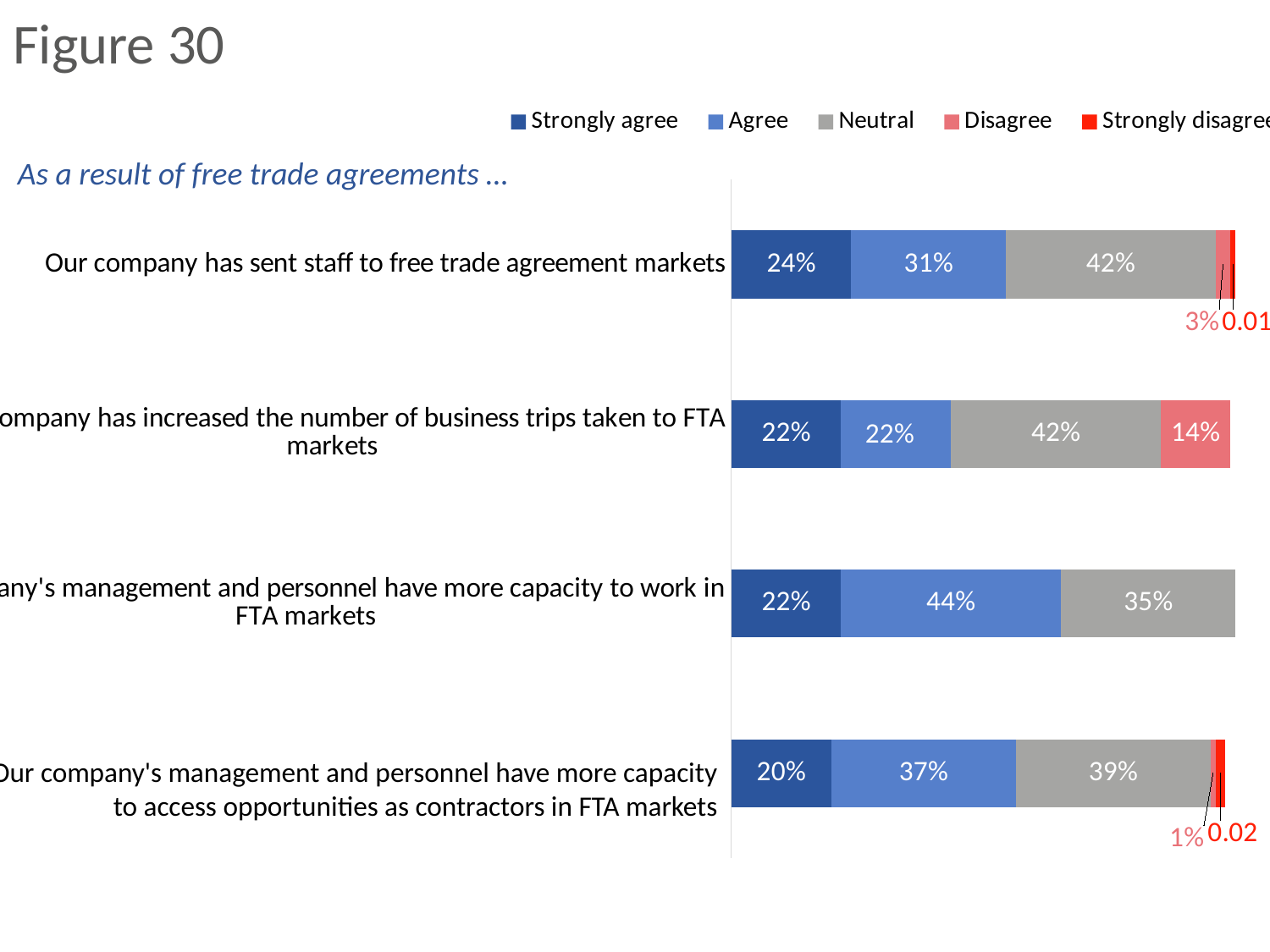
What kind of chart is shown on the slide? Stacked bar chart What is the Agree value for the statement about management and personnel having more capacity to work in FTA markets? 44% How many series does the legend list? 5 What is the Disagree value for the statement about increasing the number of business trips taken to FTA markets? 14% How many statements (categories) are plotted in the chart? 4 Which statement has the lowest Strongly agree value? Our company's management and personnel have more capacity to access opportunities as contractors in FTA markets What is the Strongly agree value for 'Our company has sent staff to free trade agreement markets'? 24% What is the Neutral value for 'Our company has sent staff to free trade agreement markets'? 42% What is the Neutral value for 'Our company's management and personnel have more capacity to access opportunities as contractors in FTA markets'? 39% Which statement has the highest Agree value? Management and personnel have more capacity to work in FTA markets What is the difference between the Agree values for the statement about sending staff to free trade agreement markets (31%) and the statement about increasing business trips to FTA markets (22%)? 9% Which is larger: the Strongly agree value for 'Our company has sent staff to free trade agreement markets' or the Strongly agree value for the statement about access opportunities as contractors in FTA markets? Our company has sent staff to free trade agreement markets